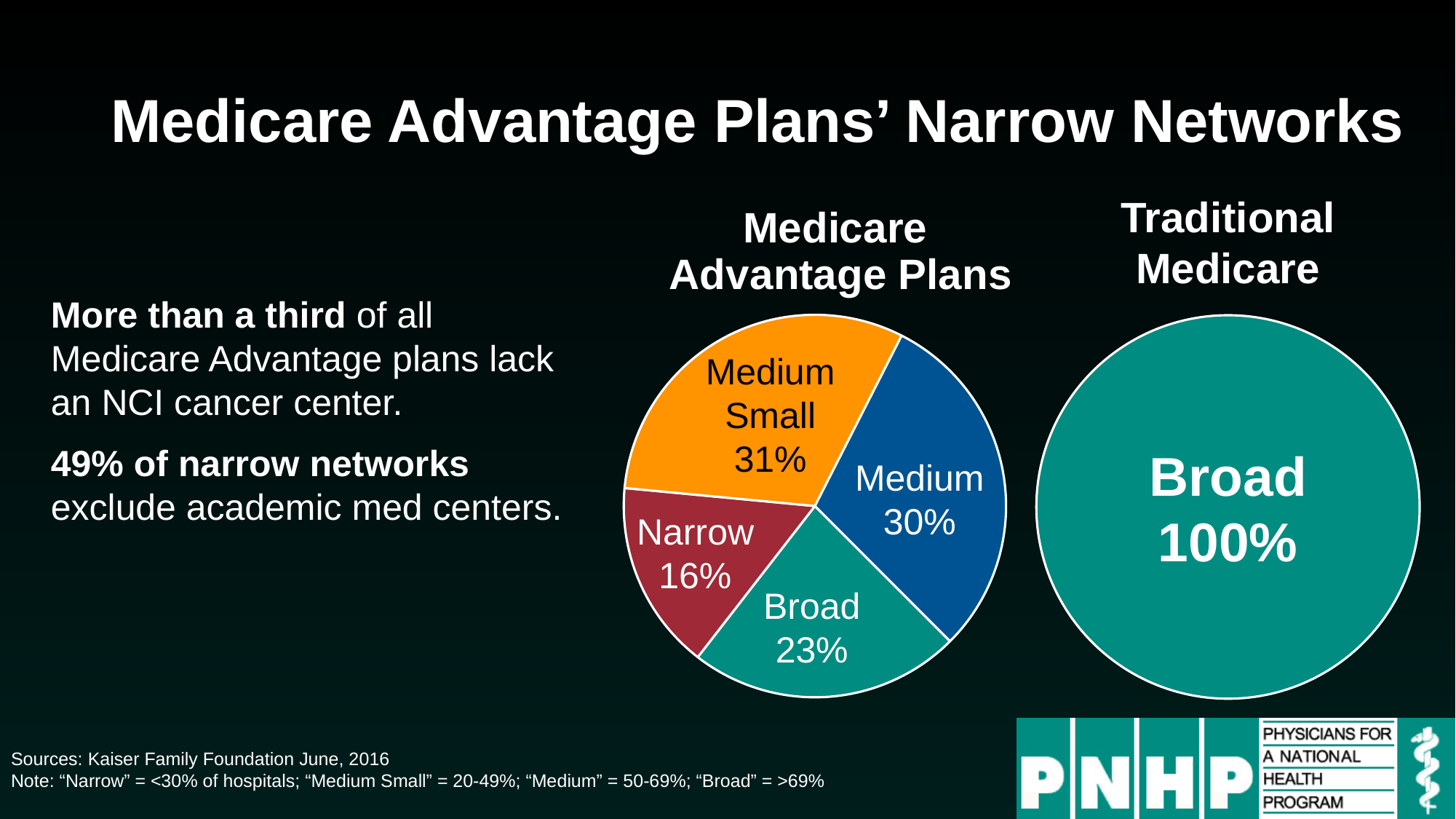
In the Traditional Medicare chart, what share is labelled Broad? 100% In the Medicare Advantage Plans chart, what share of plans have a Narrow network? 16% In the Medicare Advantage Plans chart, what is the difference in percentage points between the Medium and Broad slices? 7 In the Medicare Advantage Plans chart, what share of plans have a Medium Small network? 31% In the Medicare Advantage Plans chart, what colour is the Medium slice? Blue In the Medicare Advantage Plans chart, which is larger, the Broad slice or the Narrow slice? Broad In the Medicare Advantage Plans chart, which network category has the largest share? Medium Small How many slices does the Medicare Advantage Plans pie chart have? 4 In the Medicare Advantage Plans chart, what is the combined share of the Narrow and Medium Small slices? 47% In the Medicare Advantage Plans chart, what share of plans have a Broad network? 23% What kind of chart is used for Medicare Advantage Plans? Pie chart In the Medicare Advantage Plans chart, which network category has the smallest share? Narrow